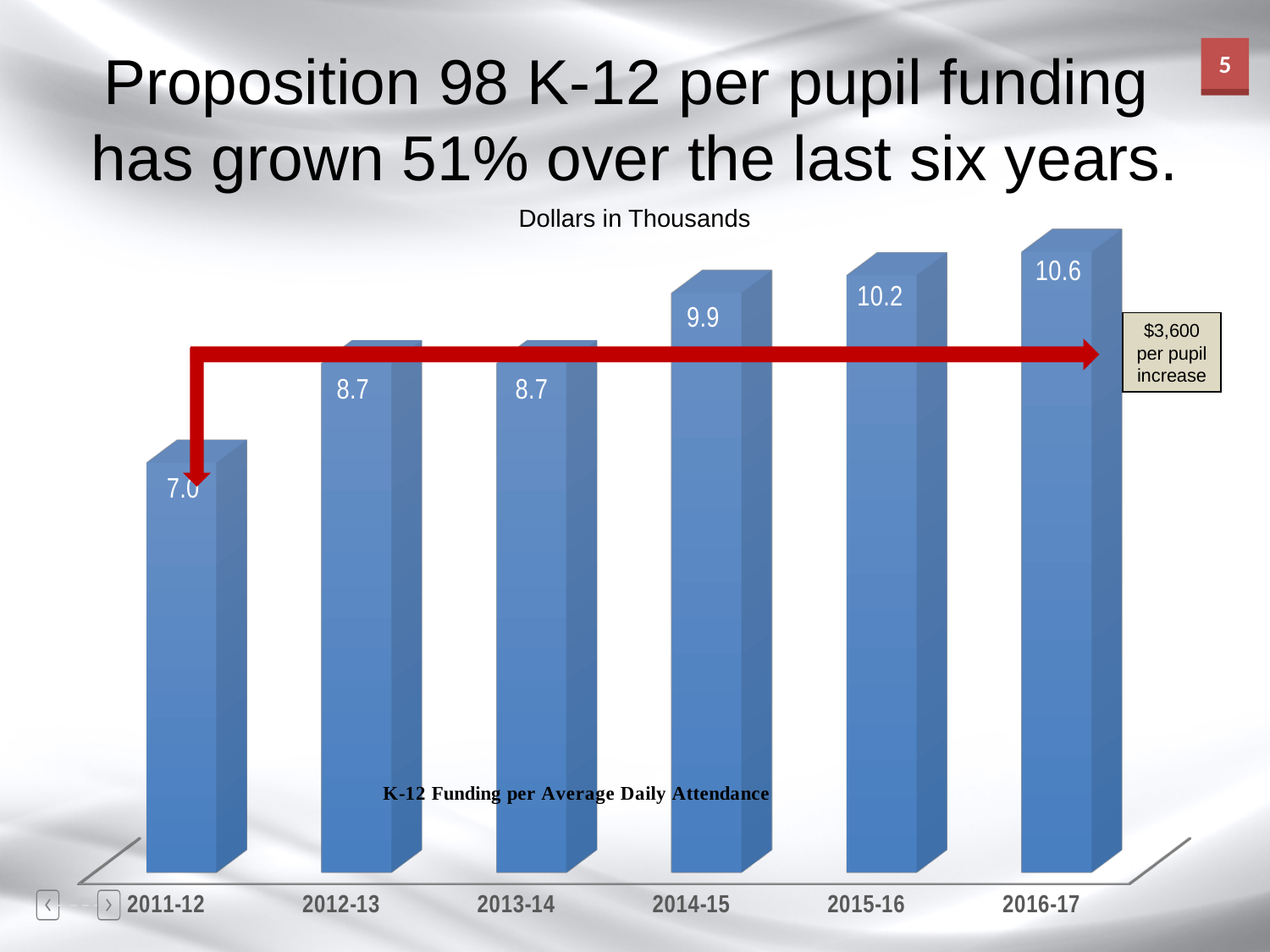
How many years are shown on the x axis? 6 What is the value shown for 2014-15? 9.9 What unit does the chart subtitle say the values are in? Dollars in Thousands What is the value shown for 2015-16? 10.2 What is the K-12 funding per average daily attendance for 2011-12? 7.0 What is the value shown for 2016-17? 10.6 What is the difference between the values for 2016-17 and 2011-12? 3.6 Which is larger, the value for 2015-16 or the value for 2014-15? 2015-16 Which year has the lowest value? 2011-12 Which year has the highest value? 2016-17 What is the difference between the values for 2014-15 and 2013-14? 1.2 What kind of chart is shown on the slide? Bar chart